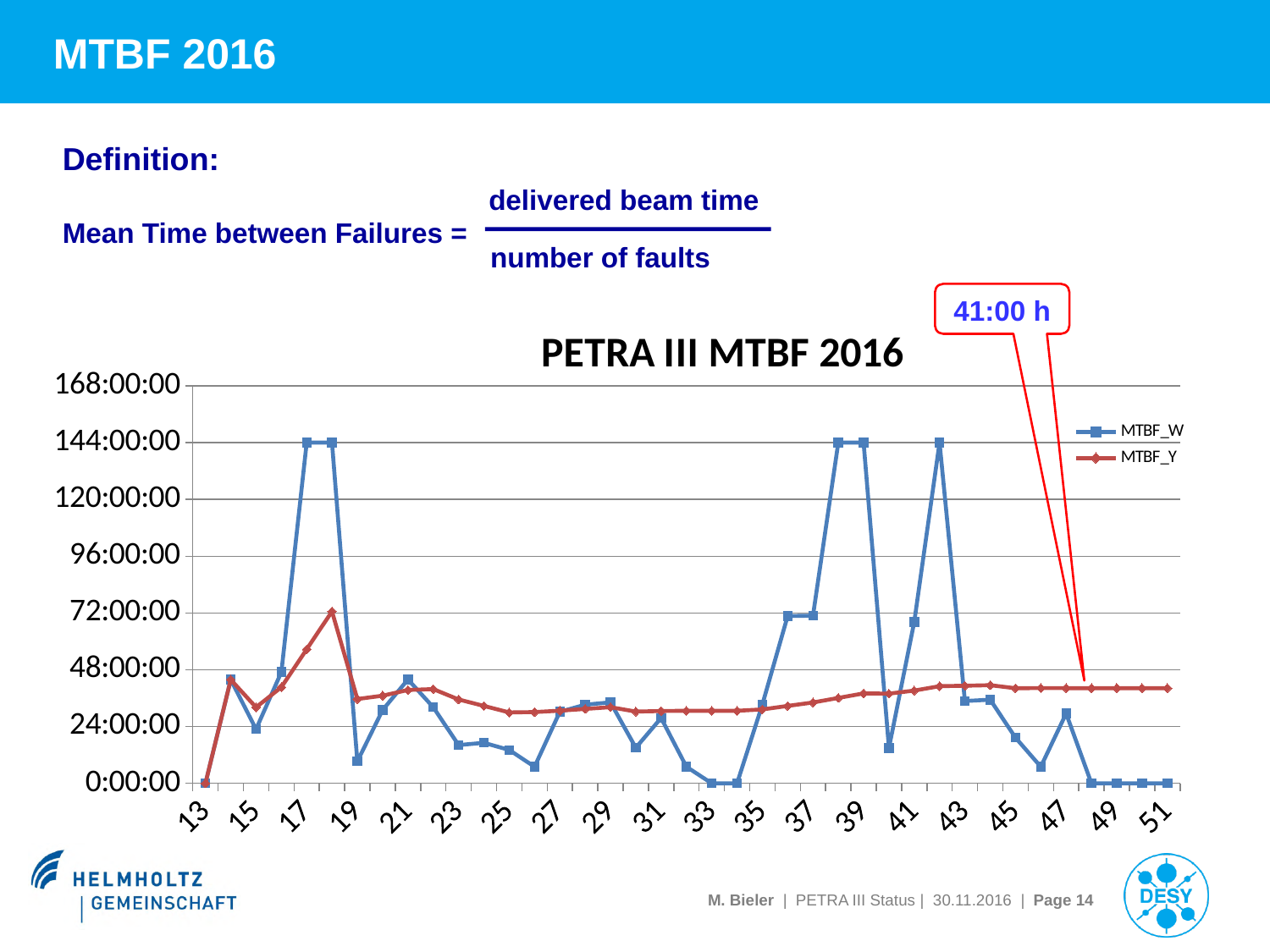
What value does the callout annotation give for the end of the MTBF_Y line? 41:00 h At week 18, which series has the larger value, MTBF_W or MTBF_Y? MTBF_W Which series reaches the highest value anywhere on the chart? MTBF_W How many series does the legend of the chart list? 2 At week 40, which series has the larger value, MTBF_W or MTBF_Y? MTBF_Y Is the MTBF_Y value at week 25 greater or less than 48:00:00? less What kind of chart is shown on the slide? line chart What is the MTBF_W value at week 49? 0:00:00 What are the two series named in the chart legend? MTBF_W and MTBF_Y Is the MTBF_W value at week 36 greater or less than 48:00:00? greater What is the title of the chart? PETRA III MTBF 2016 What is the MTBF_W value at week 17? 144:00:00